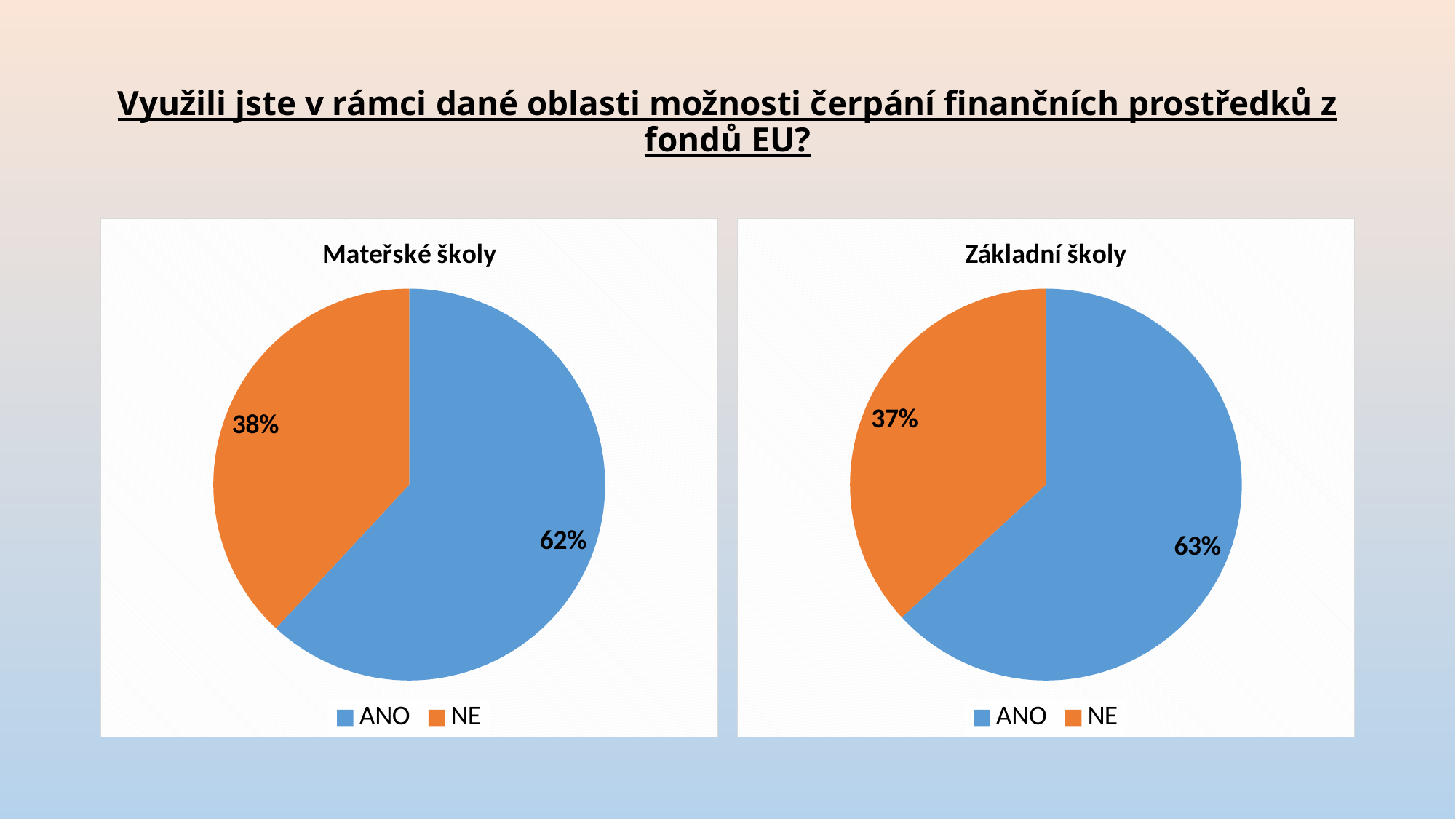
In the 'Mateřské školy' chart, what is the difference between the ANO and NE percentages? 24% What type of chart is the 'Mateřské školy' chart? Pie chart How many slices does the 'Základní školy' pie chart have? 2 In the 'Základní školy' chart, which is larger, ANO or NE? ANO In the 'Základní školy' chart, what percentage is shown for ANO? 63% In the 'Základní školy' chart, which slice is the smallest? NE In the 'Základní školy' chart, what percentage is shown for NE? 37% In the 'Mateřské školy' chart, what percentage is shown for ANO? 62% In the 'Základní školy' chart, what is the difference between the ANO and NE percentages? 26% In the 'Mateřské školy' chart, which slice is the largest? ANO In the 'Mateřské školy' chart, what colour is the ANO slice? Blue In the 'Mateřské školy' chart, what percentage is shown for NE? 38%